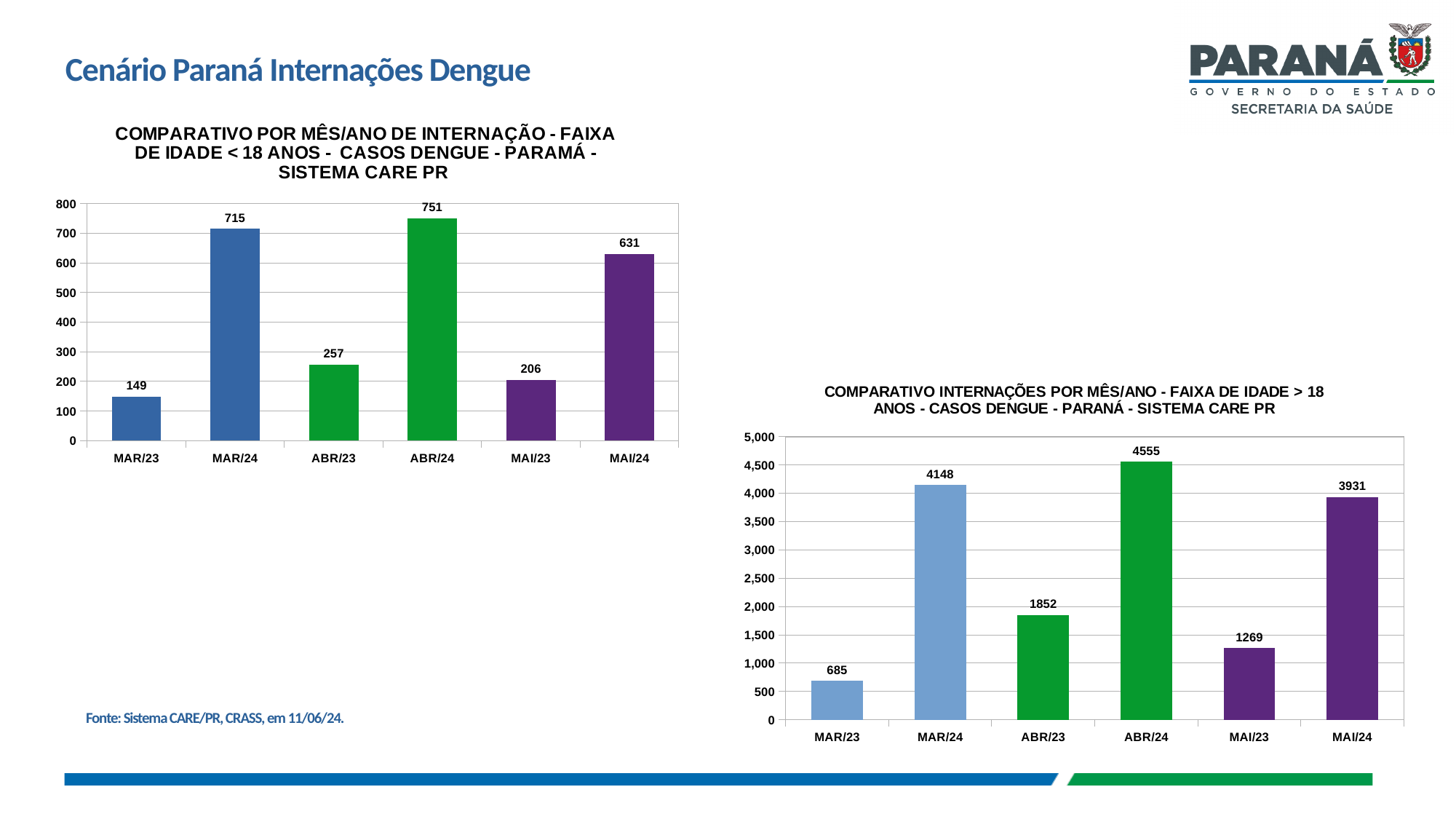
In the right chart (faixa de idade > 18 anos), which is larger, MAR/24 or MAI/24? MAR/24 In the right chart (faixa de idade > 18 anos), what is the value for MAI/23? 1269 What kind of chart is the left chart (faixa de idade < 18 anos)? Bar chart In the right chart (faixa de idade > 18 anos), is the value for ABR/23 greater or less than 2,000? less In the left chart (faixa de idade < 18 anos), what is the difference between ABR/24 and ABR/23? 494 In the right chart (faixa de idade > 18 anos), which month/year has the lowest value? MAR/23 In the right chart (faixa de idade > 18 anos), what is the difference between MAR/24 and MAR/23? 3463 In the left chart (faixa de idade < 18 anos), how many bars are plotted? 6 In the right chart (faixa de idade > 18 anos), which month/year has the highest value? ABR/24 In the left chart (faixa de idade < 18 anos), which month/year has the lowest value? MAR/23 In the left chart (faixa de idade < 18 anos), which month/year has the highest value? ABR/24 In the left chart (faixa de idade < 18 anos), what is the value for MAR/24? 715